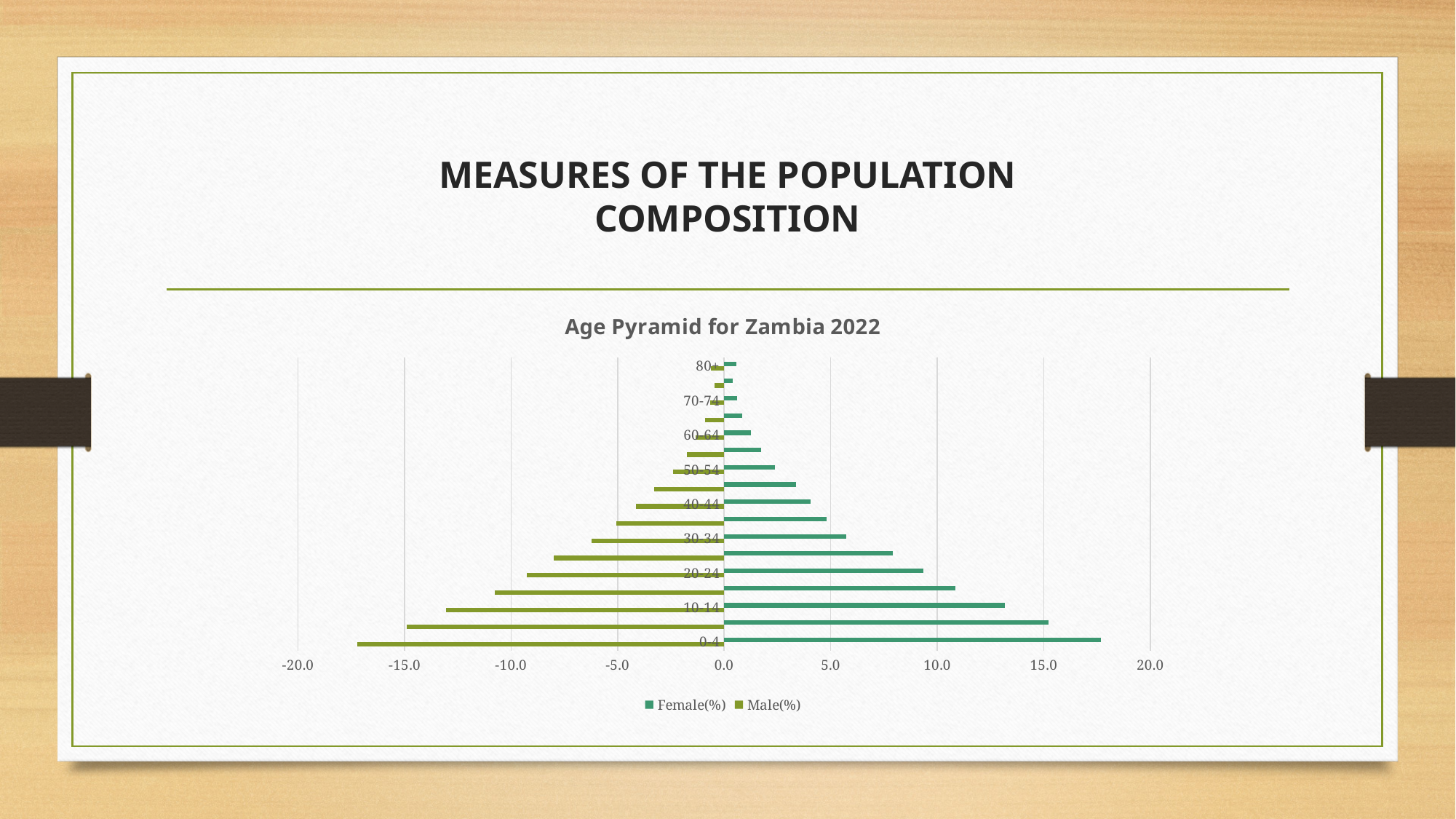
Do the Female(%) values rise or fall as the age groups go from 0-4 up to 80+? fall Which age group has the highest Female(%) value? 0-4 How many series does the chart's legend list? 2 Is the Female(%) value for the 40-44 age group greater or less than 5.0? less Which is larger, the Female(%) value for the 0-4 age group or for the 10-14 age group? 0-4 What is the title of the chart on the slide? Age Pyramid for Zambia 2022 How many age-group bars are plotted for the Female(%) series? 17 What kind of chart is shown on the slide? bar chart Which two series are listed in the chart's legend? Female(%) and Male(%) Is the Female(%) value for the 20-24 age group greater or less than 10.0? less Is the Female(%) value for the 0-4 age group greater or less than 15.0? greater